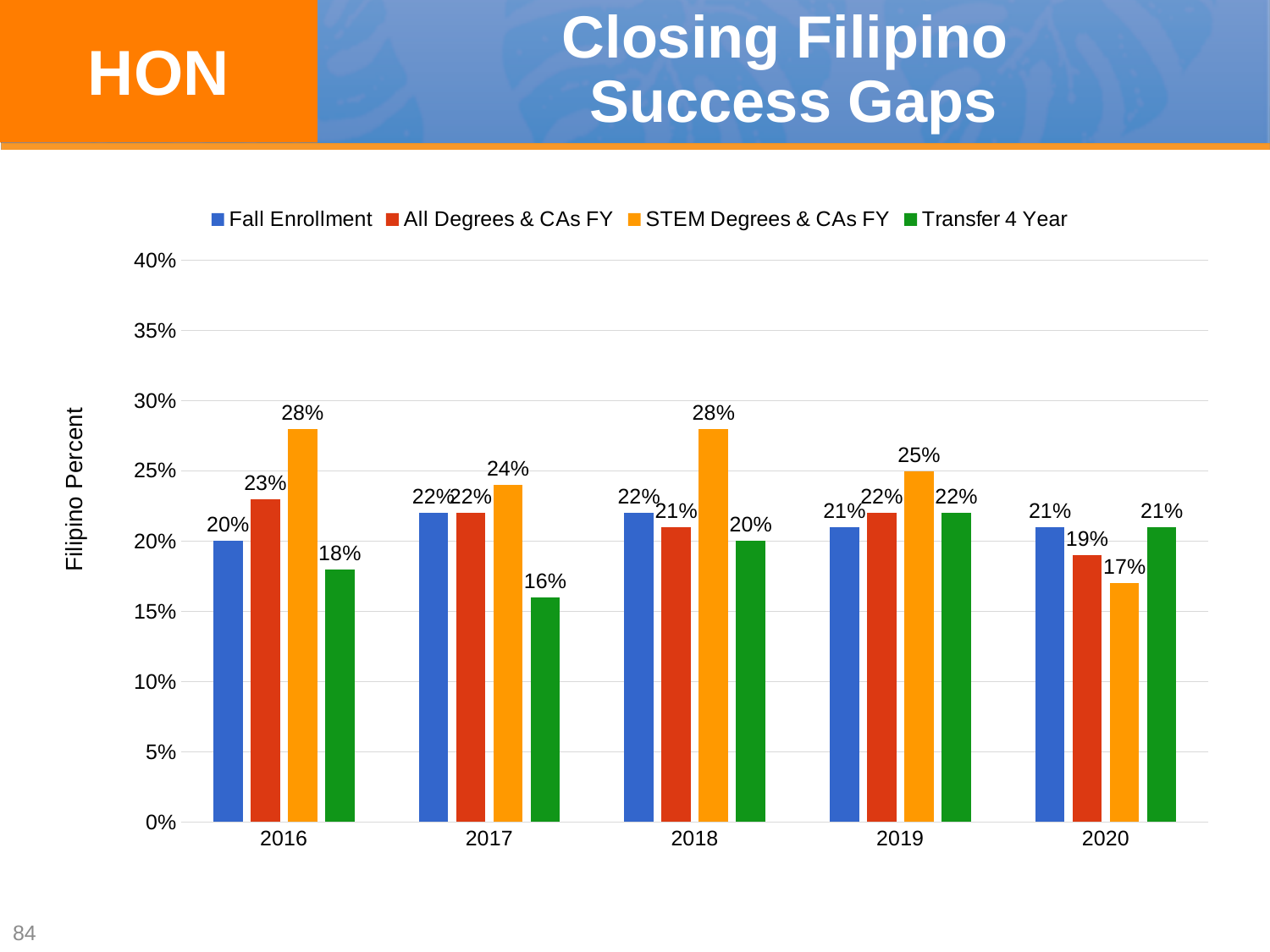
What kind of chart is shown on the slide? Bar chart What is the STEM Degrees & CAs FY value for 2016? 28% How many years are shown on the x axis? 5 What is the label on the vertical axis? Filipino Percent What is the Fall Enrollment value for 2018? 22% In which year is the Transfer 4 Year value lowest? 2017 What is the Transfer 4 Year value for 2017? 16% What is the All Degrees & CAs FY value for 2020? 19% What is the difference between the STEM Degrees & CAs FY value and the Transfer 4 Year value in 2016? 10% How many series does the legend list? 4 Which is larger in 2019: the STEM Degrees & CAs FY value or the Fall Enrollment value? STEM Degrees & CAs FY In which year is the STEM Degrees & CAs FY value lowest? 2020